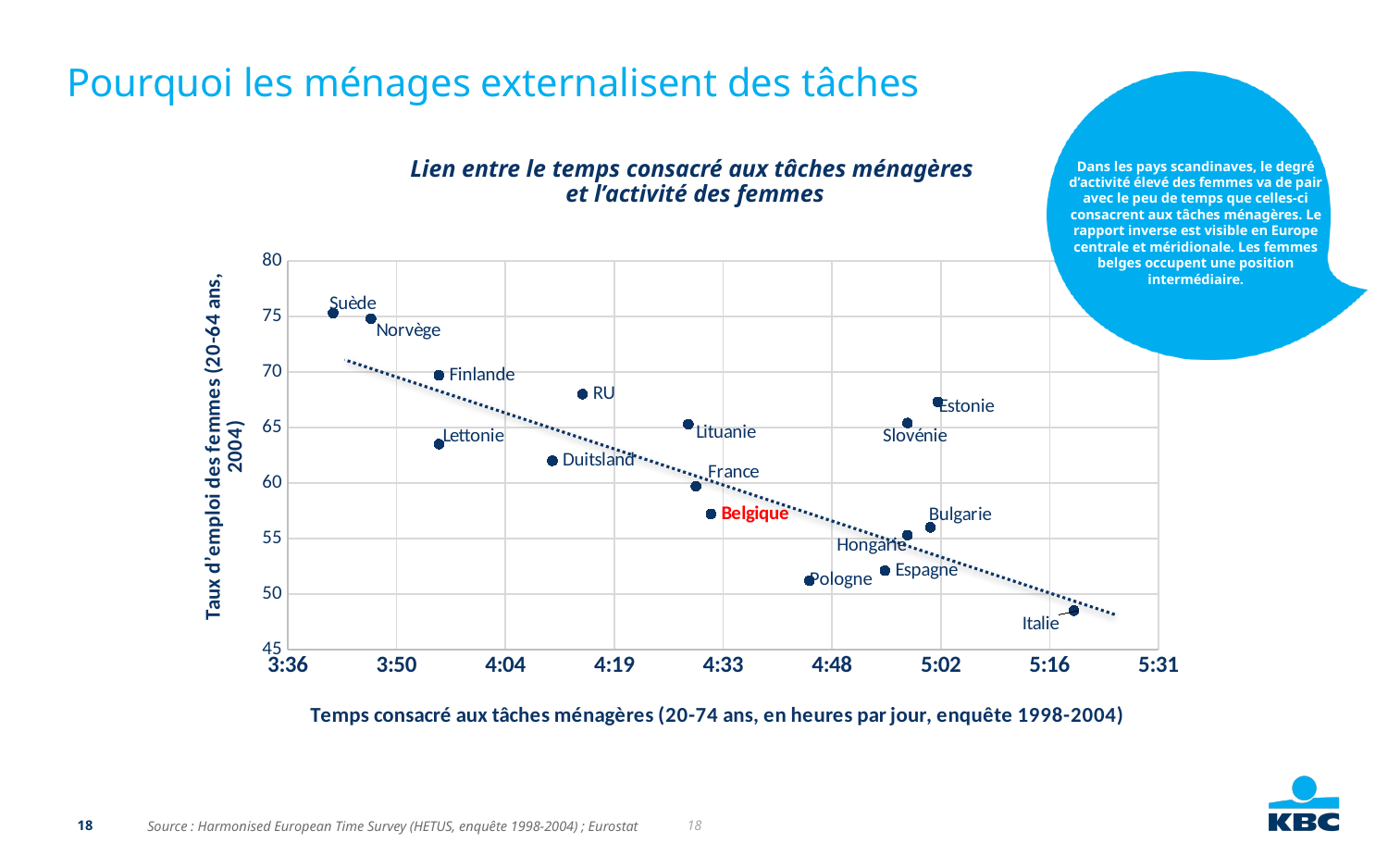
Which country spends the most time on household tasks according to the chart? Italie How many countries are plotted on the chart? 16 What kind of chart is shown on the slide? Scatter chart Which country has the lowest female employment rate on the chart? Italie Which has a higher female employment rate, Estonie or Bulgarie? Estonie Is the female employment rate for Finlande greater or less than 65? greater Is the female employment rate for Pologne greater or less than 55? less Which country's label is highlighted in red on the chart? Belgique Which country spends the least time on household tasks according to the chart? Suède Is the female employment rate for Belgique greater or less than 60? less As the time spent on household tasks increases along the x axis, does the female employment rate generally rise or fall? Fall